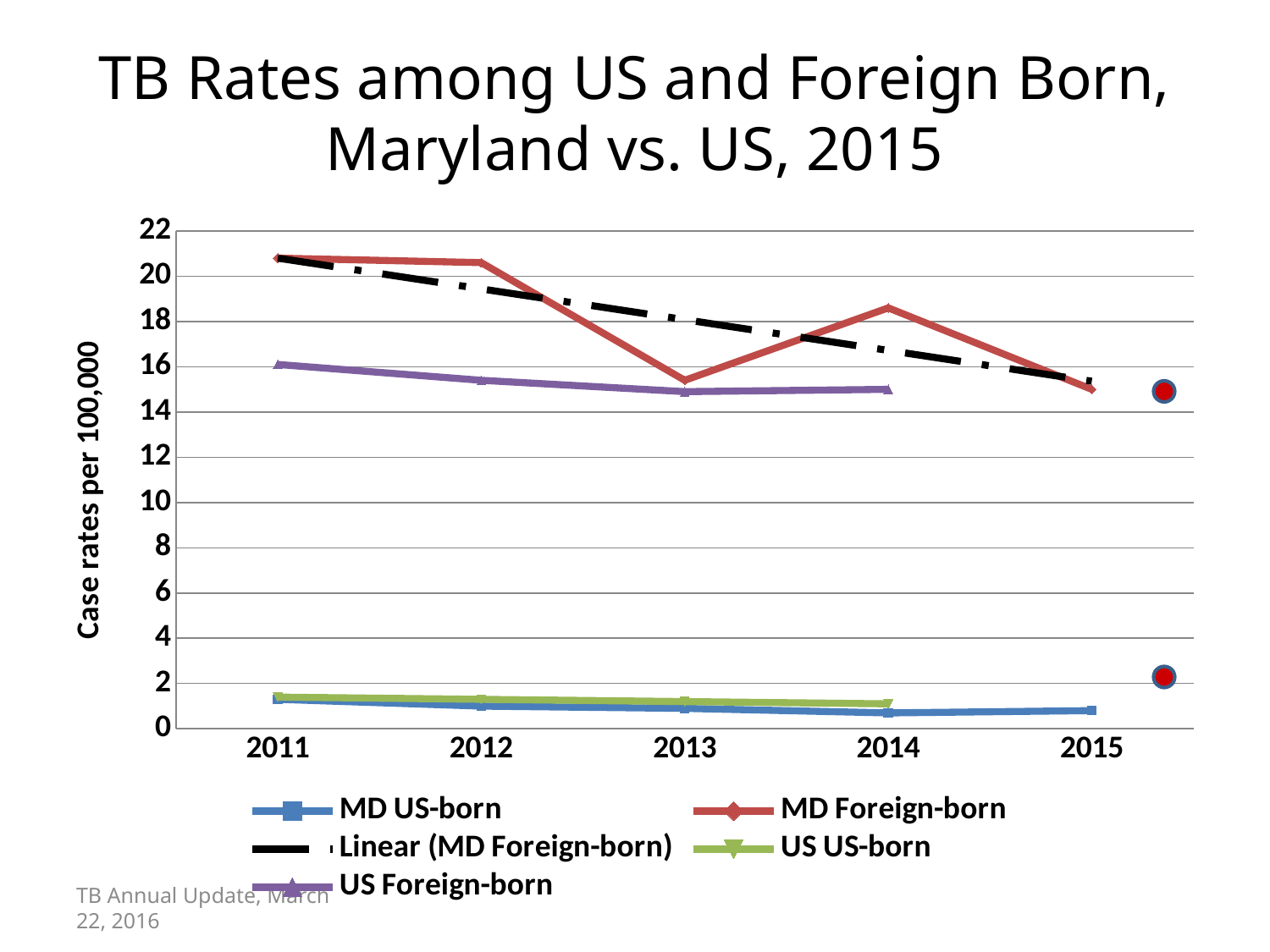
Is the value for MD US-born in 2011 greater or less than 2? less Is the value for MD Foreign-born in 2011 greater or less than 20? greater In 2011, which is higher: MD Foreign-born or US Foreign-born? MD Foreign-born Is the value for MD Foreign-born in 2013 greater or less than 16? less Does the US Foreign-born line rise or fall from 2011 to 2014? fall What is the label of the y axis? Case rates per 100,000 Which legend entry is drawn as a black dashed line? Linear (MD Foreign-born) How many series does the legend list? 5 What kind of chart is shown on the slide? line chart For MD Foreign-born, which year has the higher value: 2012 or 2013? 2012 How many years are shown on the x axis? 5